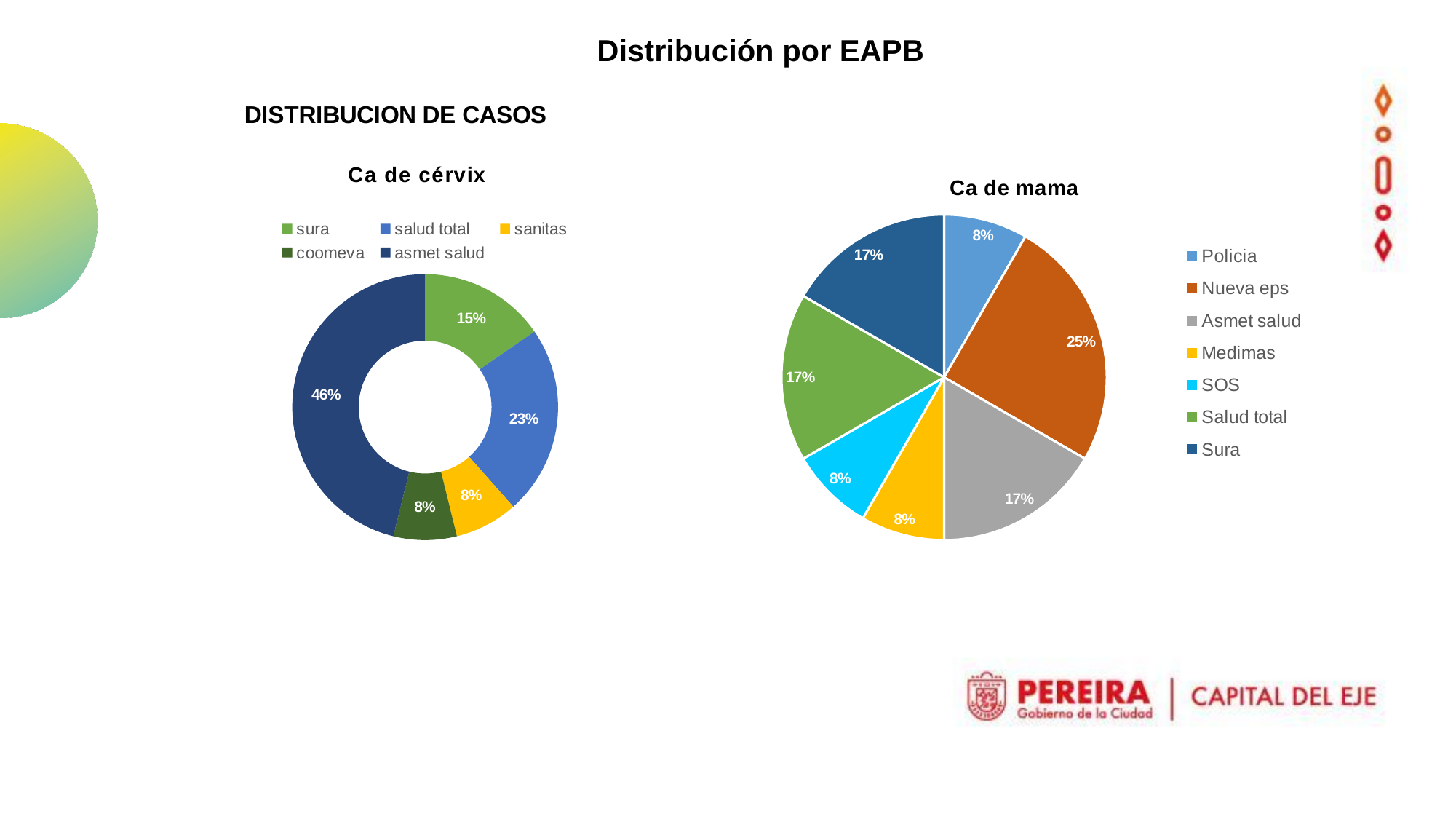
In the 'Ca de mama' chart, which is larger, the share of Nueva eps or the share of Asmet salud? Nueva eps In the 'Ca de cérvix' chart, which category has the largest share? asmet salud In the 'Ca de cérvix' chart, what share does asmet salud have? 46% In the 'Ca de cérvix' chart, what share does salud total have? 23% In the 'Ca de mama' chart, what colour is the Nueva eps slice? Orange In the 'Ca de cérvix' chart, how many categories does the legend list? 5 In the 'Ca de mama' chart, what share does Nueva eps have? 25% In the 'Ca de cérvix' chart, what is the difference between the shares of asmet salud and salud total? 23% In the 'Ca de mama' chart, how many categories does the legend list? 7 What kind of chart is the 'Ca de cérvix' chart? Doughnut chart In the 'Ca de mama' chart, what is the difference between the shares of Nueva eps and Policia? 17% In the 'Ca de mama' chart, which category has the largest share? Nueva eps